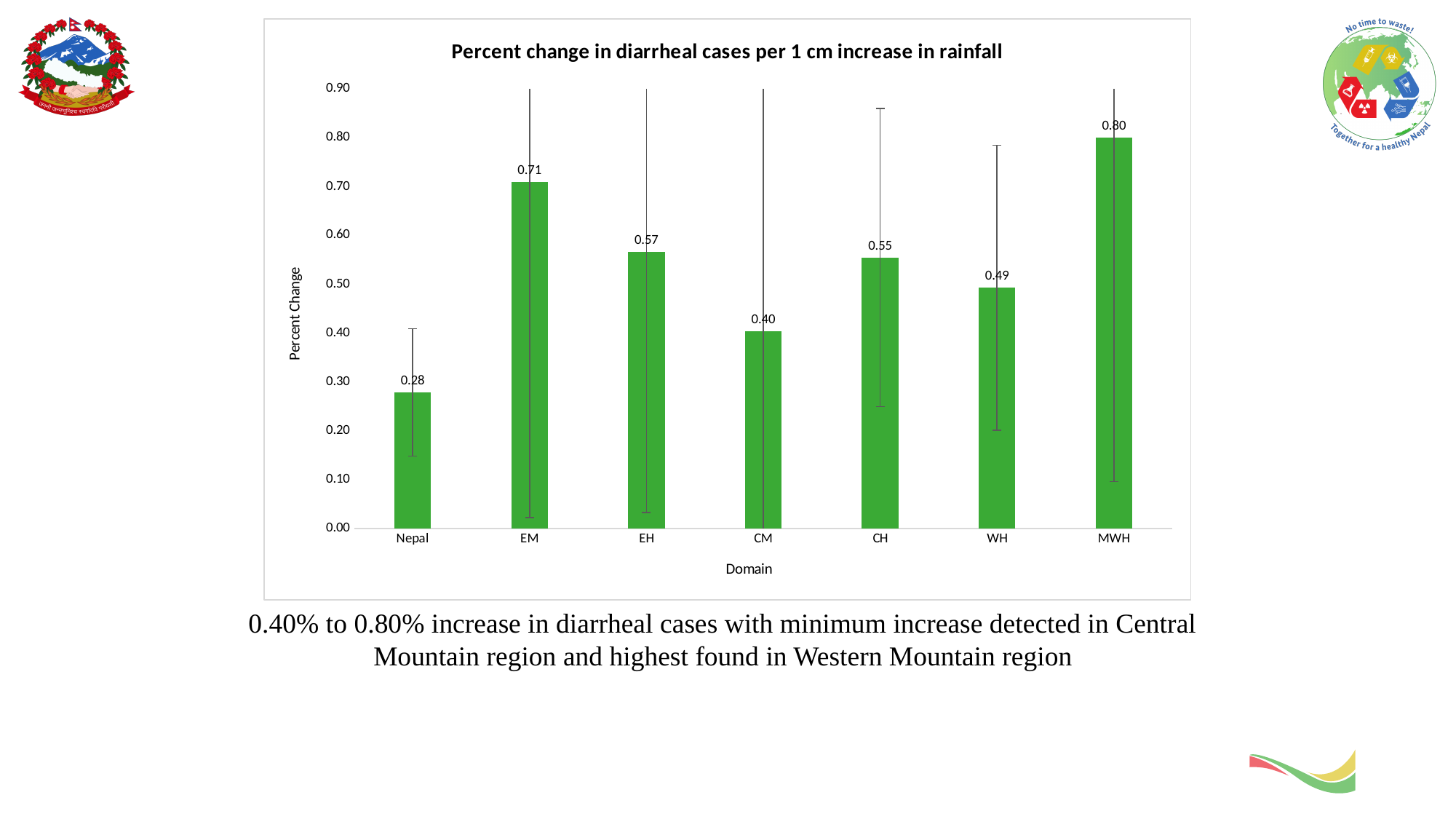
Which domain has the lowest percent change? Nepal What is the difference between the values for EM and EH? 0.14 How many domains are shown on the x axis? 7 What is the value shown for CH? 0.55 Which domain has the highest percent change? MWH What is the value shown for the Nepal bar? 0.28 What is the difference between the values for MWH and CM? 0.40 Is the value for EH greater or less than 0.50? greater Which has a larger value, WH or CH? CH What is the title of the chart? Percent change in diarrheal cases per 1 cm increase in rainfall What is the percent change in diarrheal cases for EM? 0.71 What kind of chart is shown? Bar chart